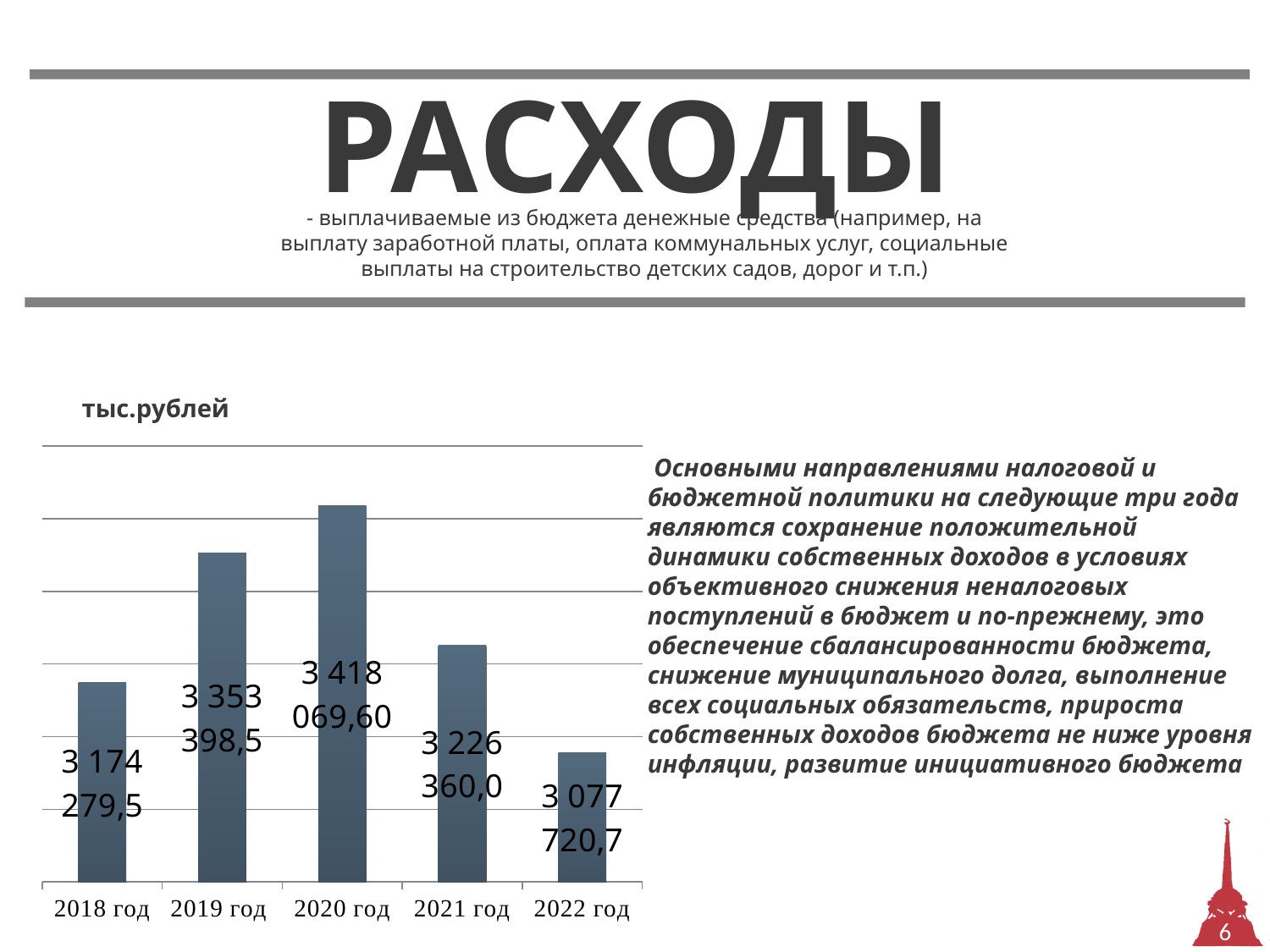
What is the difference between the values for 2018 год and 2022 год? 96 558,8 What is the difference between the values for 2020 год and 2019 год? 64 671,1 How many years are shown on the chart? 5 What kind of chart is shown on the slide? bar chart Which year has the highest value? 2020 год Do the values rise or fall from 2020 год to 2022 год? fall Which is larger, the value for 2019 год or the value for 2021 год? 2019 год What is the value for 2022 год? 3 077 720,7 What is the value for 2021 год? 3 226 360,0 What is the value for 2018 год? 3 174 279,5 What is the value for 2020 год? 3 418 069,60 Which year has the lowest value? 2022 год